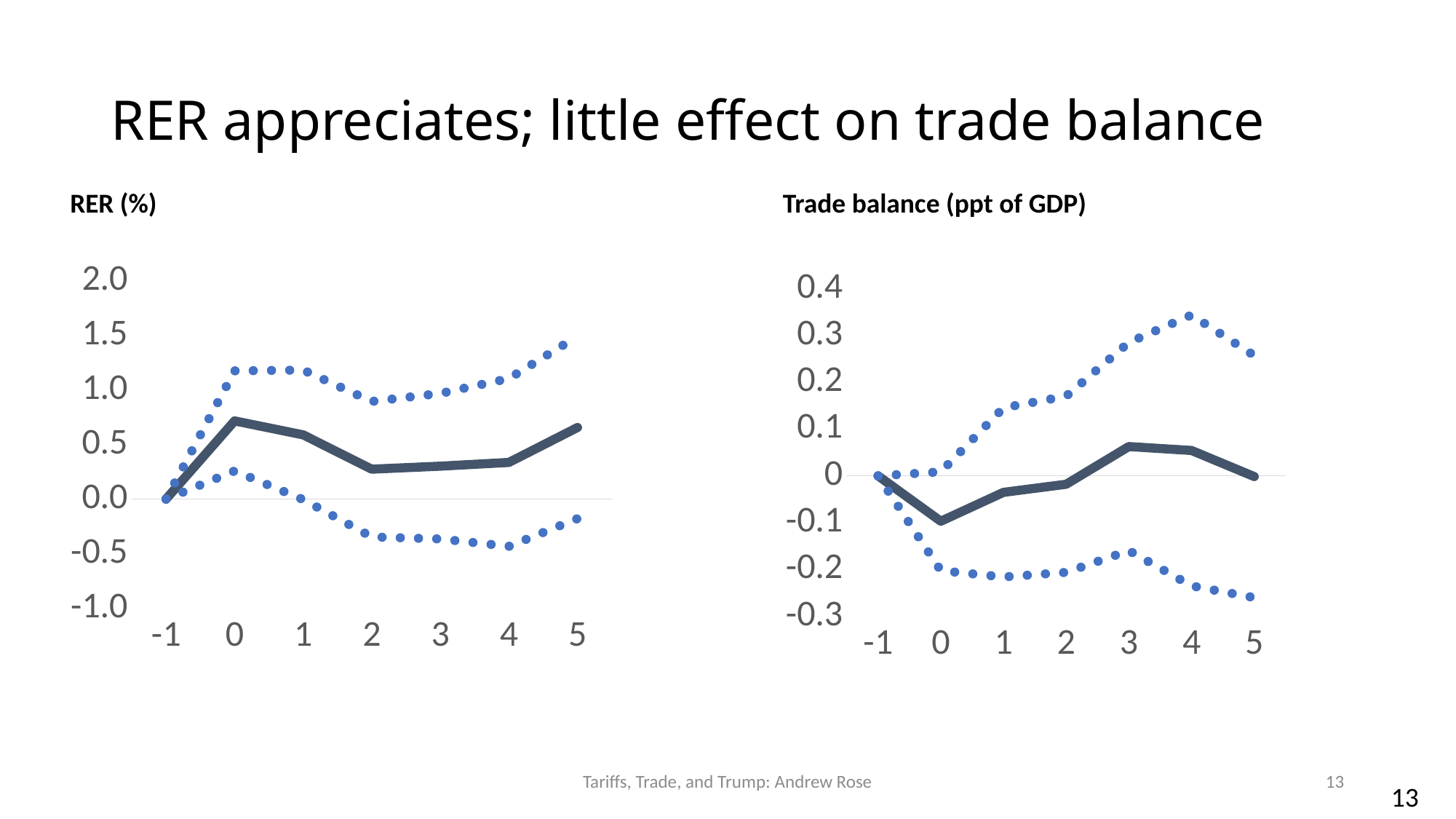
What kind of chart is the Trade balance (ppt of GDP) chart? line chart In the RER (%) chart, does the solid line rise or fall between x = -1 and x = 0? rise In the Trade balance (ppt of GDP) chart, what is the value of the solid line at x = -1? 0 In the RER (%) chart, how many points are labelled on the x axis? 7 In the Trade balance (ppt of GDP) chart, is the value of the solid line at x = 0 greater or less than 0? less In the RER (%) chart, is the value of the solid line at x = 0 greater or less than 0.5? greater In the Trade balance (ppt of GDP) chart, is the value of the upper dotted line at x = 4 greater or less than 0.3? greater In the RER (%) chart, at which x value does the solid line reach its highest point? 0 In the RER (%) chart, what is the value of the solid line at x = -1? 0.0 What kind of chart is the RER (%) chart? line chart In the Trade balance (ppt of GDP) chart, at which x value does the solid line reach its lowest point? 0